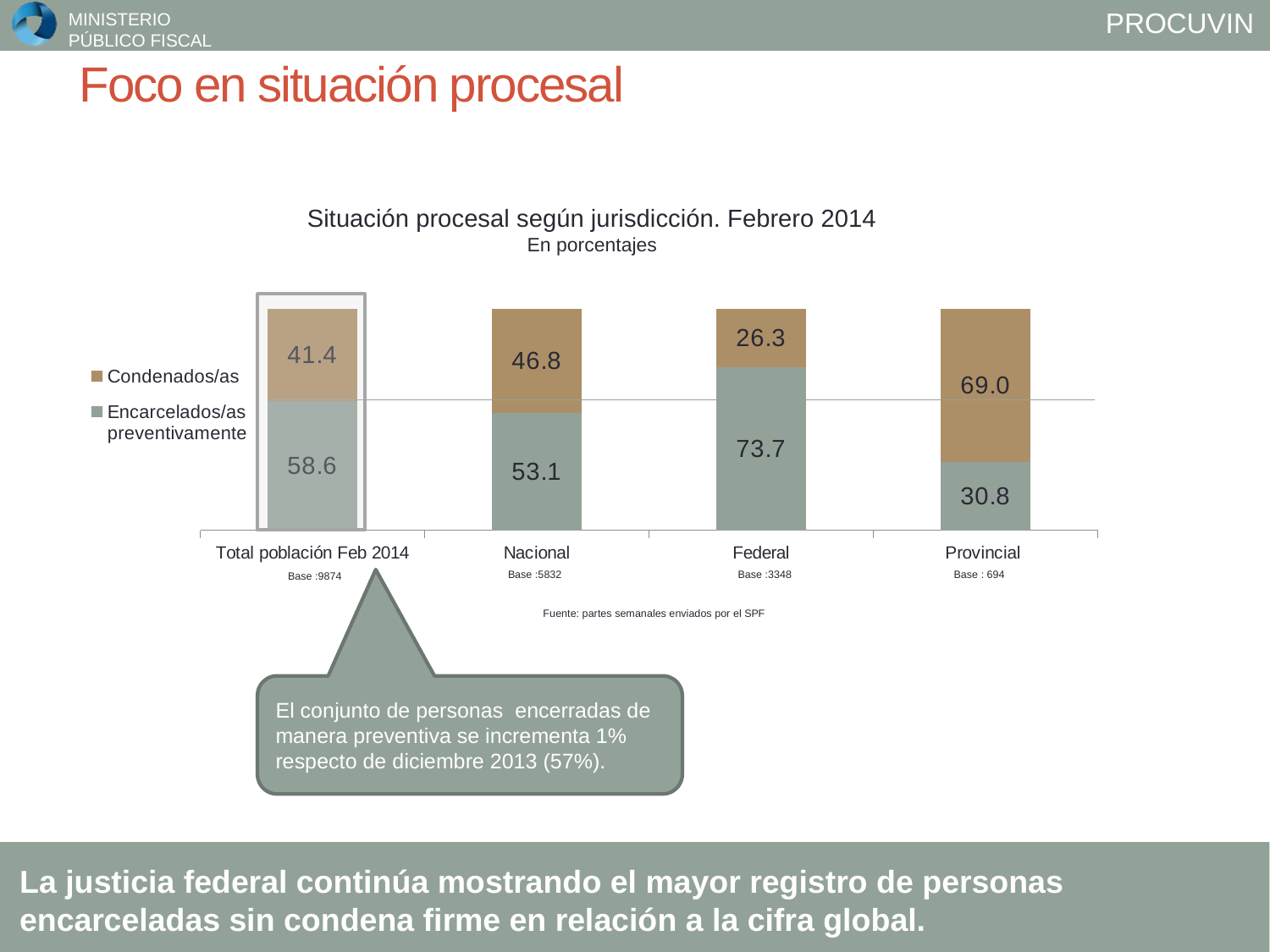
What is the value for Encarcelados/as preventivamente in the Federal jurisdiction? 73.7 How many jurisdiction categories are shown on the x axis? 4 What is the value for Encarcelados/as preventivamente in the Nacional jurisdiction? 53.1 What is the value for Condenados/as in the Provincial jurisdiction? 69.0 Which category has the lowest value for Condenados/as? Federal Which is larger: the Condenados/as value for Nacional or for Provincial? Provincial What kind of chart is shown on the slide? Stacked bar chart What is the title of the chart? Situación procesal según jurisdicción. Febrero 2014 Which category has the highest value for Encarcelados/as preventivamente? Federal What is the difference between the Encarcelados/as preventivamente values for Federal and Provincial? 42.9 How many series does the legend list? 2 What is the value for Condenados/as for Total población Feb 2014? 41.4